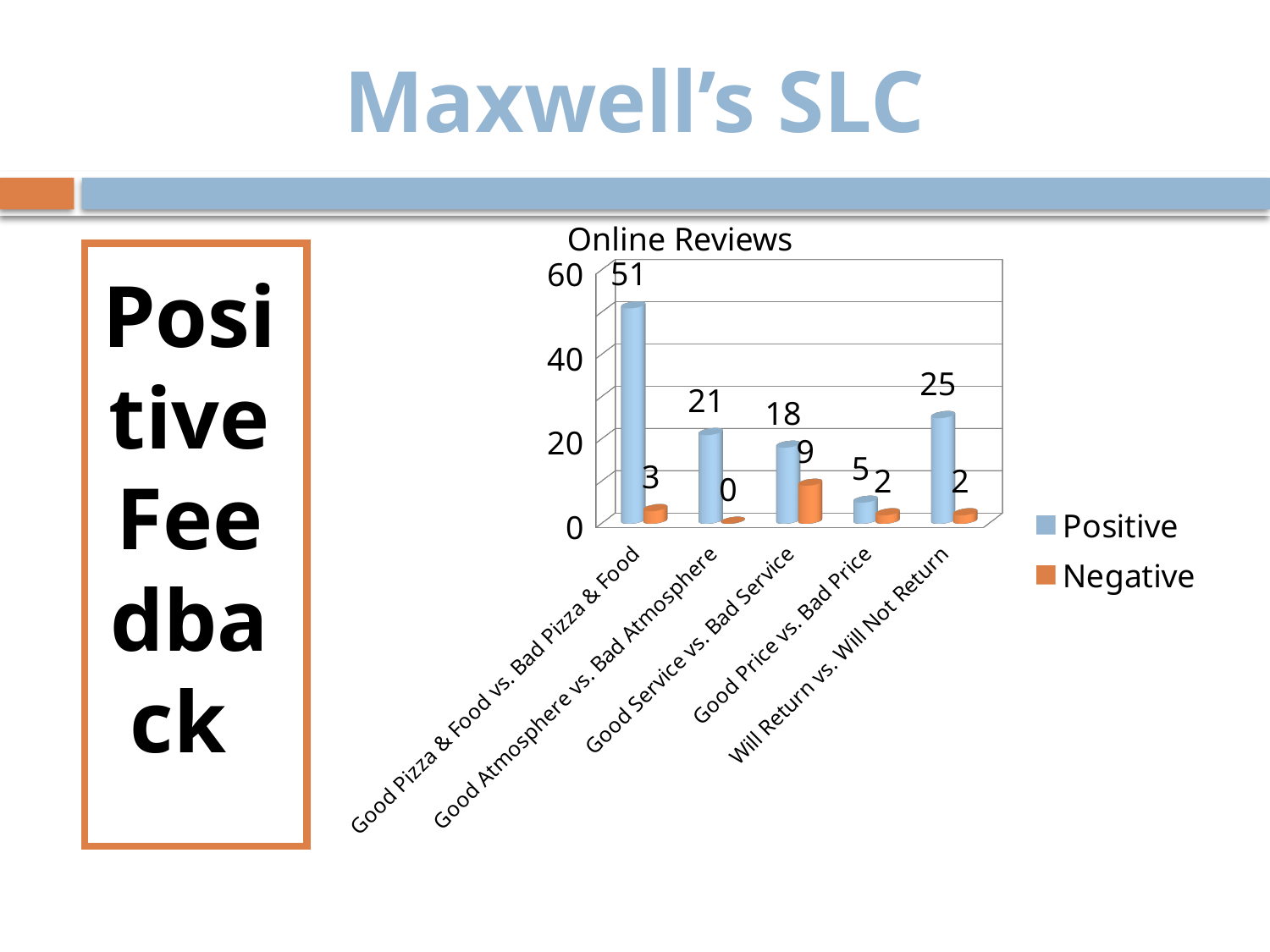
What is the Positive value for Good Pizza & Food vs. Bad Pizza & Food? 51 What type of chart is shown on the slide? bar chart How many categories are shown on the x axis? 5 Is the Positive value for Good Pizza & Food vs. Bad Pizza & Food greater or less than 40? greater Which is larger, the Positive value for Good Atmosphere vs. Bad Atmosphere or the Positive value for Will Return vs. Will Not Return? Will Return vs. Will Not Return What is the Negative value for Good Atmosphere vs. Bad Atmosphere? 0 Which category has the lowest Positive value? Good Price vs. Bad Price What is the Negative value for Good Service vs. Bad Service? 9 How many series does the legend list? 2 Which category has the highest Positive value? Good Pizza & Food vs. Bad Pizza & Food What is the Positive value for Will Return vs. Will Not Return? 25 What is the difference between the Positive and Negative values for Good Service vs. Bad Service? 9